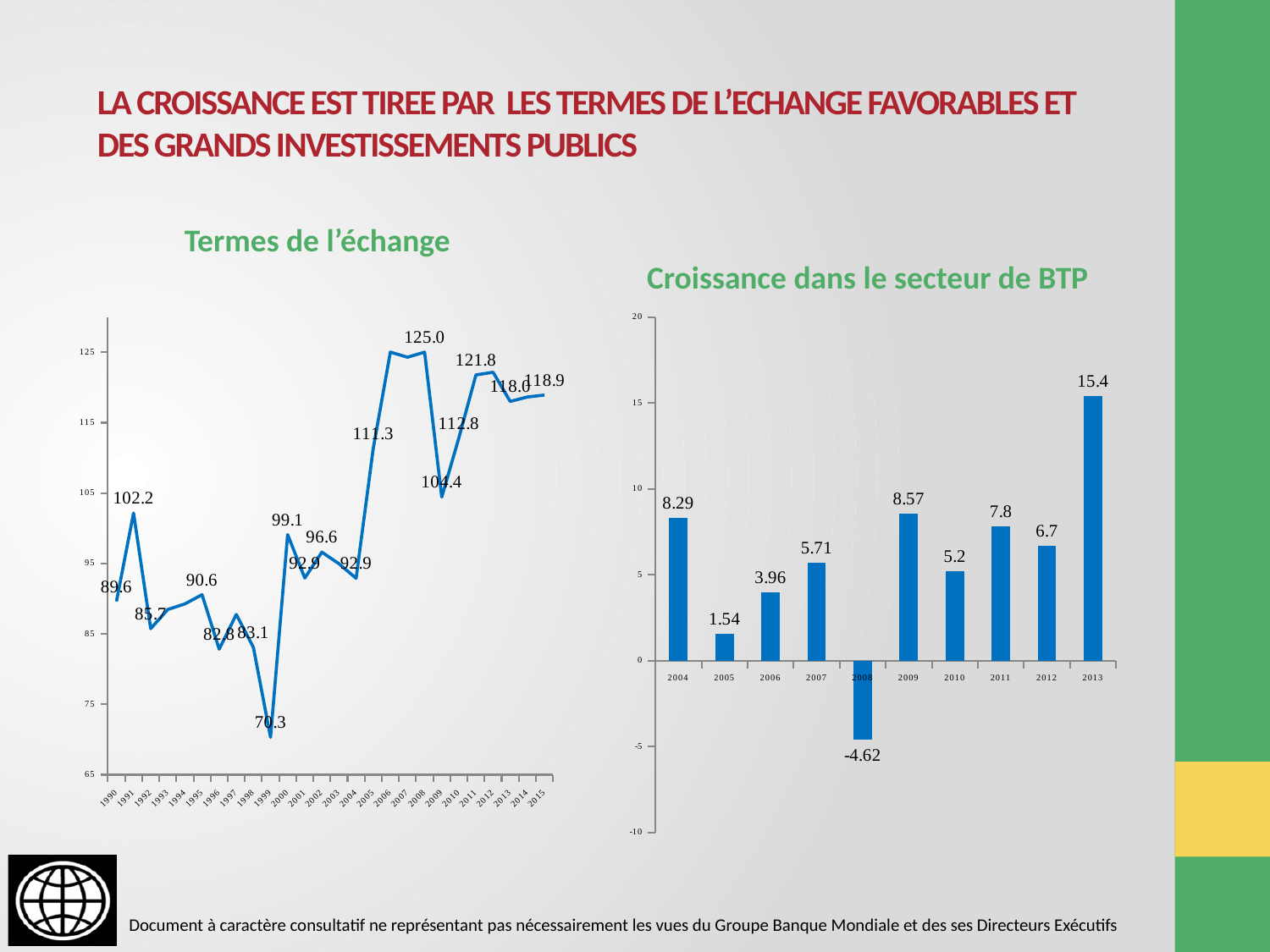
In the "Termes de l'échange" chart, what is the lowest value shown? 70.3 In the "Croissance dans le secteur de BTP" chart, what is the difference between the values for 2013 and 2004? 7.11 In the "Termes de l'échange" chart, what is the value for 1991? 102.2 In the "Croissance dans le secteur de BTP" chart, which year has the highest value? 2013 In the "Croissance dans le secteur de BTP" chart, which year has the lowest value? 2008 What kind of chart is "Termes de l'échange"? line chart What kind of chart is "Croissance dans le secteur de BTP"? bar chart In the "Croissance dans le secteur de BTP" chart, what is the value for 2013? 15.4 How many bars are shown in the "Croissance dans le secteur de BTP" chart? 10 In the "Croissance dans le secteur de BTP" chart, which is larger, the value for 2009 or the value for 2011? 2009 In the "Termes de l'échange" chart, what is the highest value shown? 125.0 In the "Croissance dans le secteur de BTP" chart, what is the value for 2008? -4.62